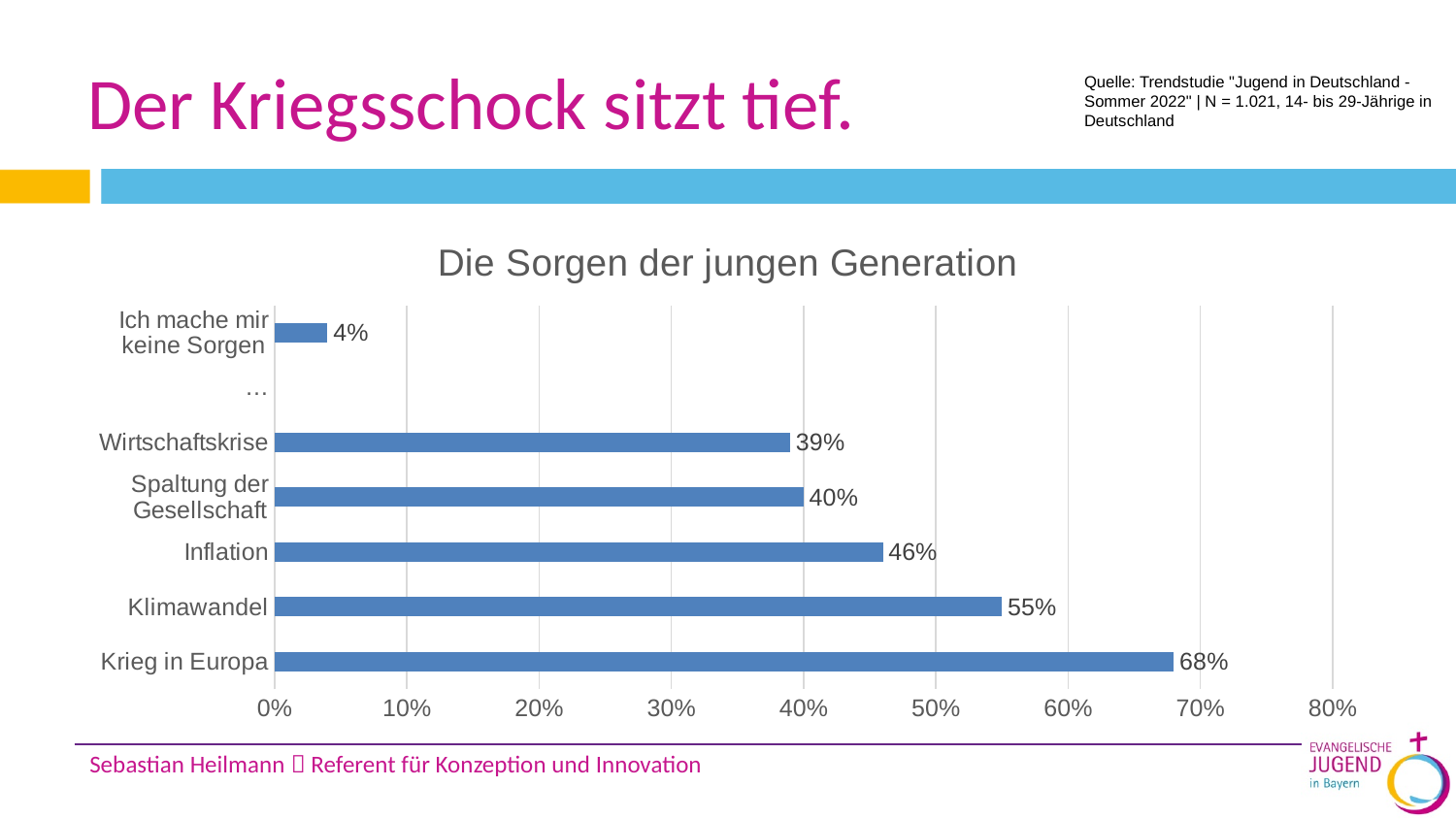
What is the value for Inflation? 46% Which is larger, the value for Inflation or the value for Wirtschaftskrise? Inflation What is the value for Spaltung der Gesellschaft? 40% How many bars are plotted in the chart? 6 What is the value for Klimawandel? 55% What is the title of the chart? Die Sorgen der jungen Generation What is the value for Krieg in Europa? 68% What is the difference between the values for Krieg in Europa and Klimawandel? 13% What kind of chart is shown on the slide? Bar chart Which category has the lowest value? Ich mache mir keine Sorgen Which category has the highest value? Krieg in Europa What is the value for Ich mache mir keine Sorgen? 4%